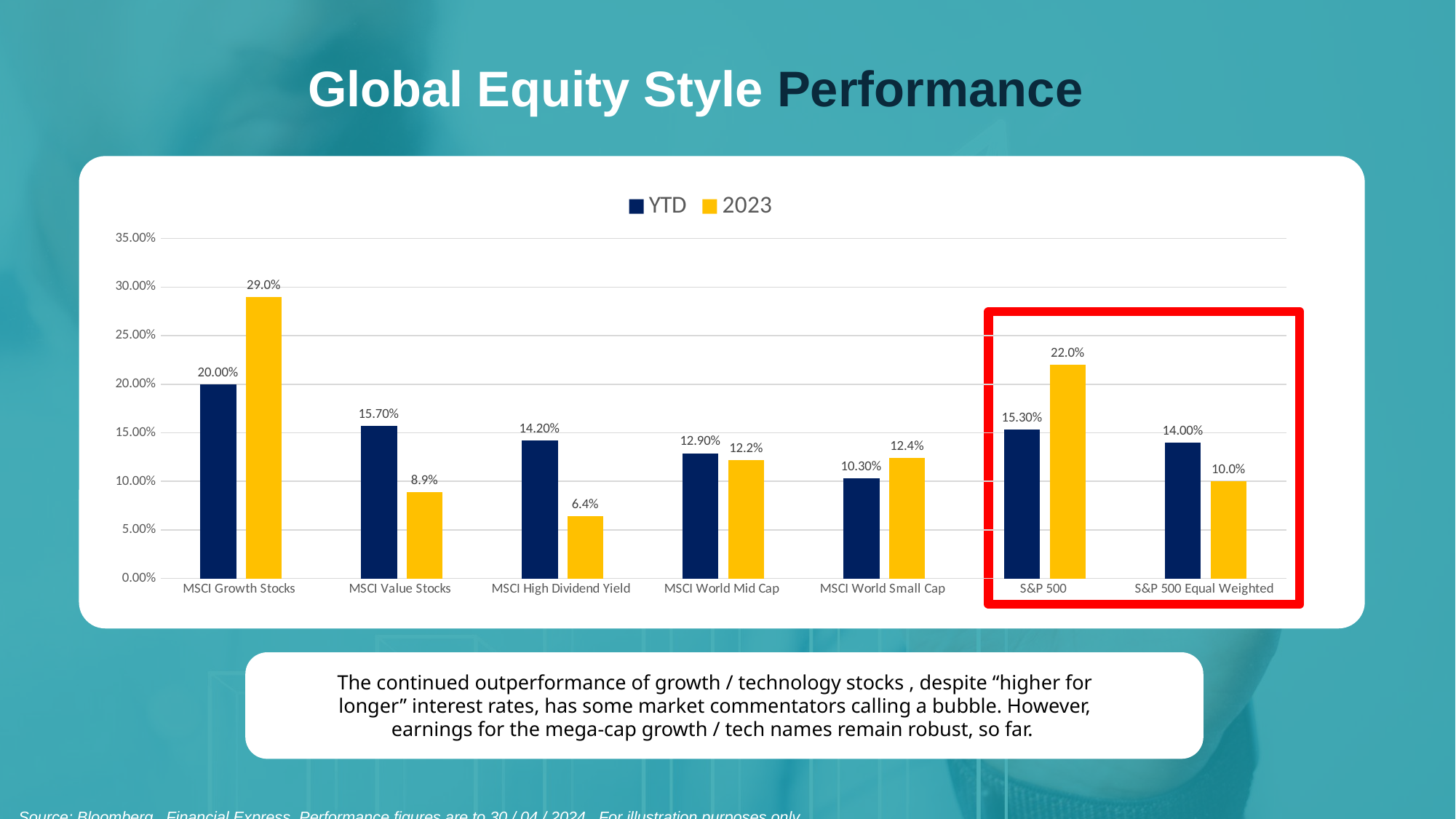
What is the 2023 value for MSCI Value Stocks? 8.9% Which category has the lowest 2023 value? MSCI High Dividend Yield What kind of chart is shown on the slide? Bar chart What is the YTD value for MSCI Growth Stocks? 20.00% What is the YTD value for S&P 500 Equal Weighted? 14.00% How many categories are shown on the x axis? 7 What is the 2023 value for S&P 500? 22.0% Which category has the highest 2023 value? MSCI Growth Stocks What is the difference between the 2023 and YTD values for MSCI Growth Stocks? 9.0% Which category has the lowest YTD value? MSCI World Small Cap How many series does the legend list? 2 Which is larger for MSCI High Dividend Yield, the YTD value or the 2023 value? YTD